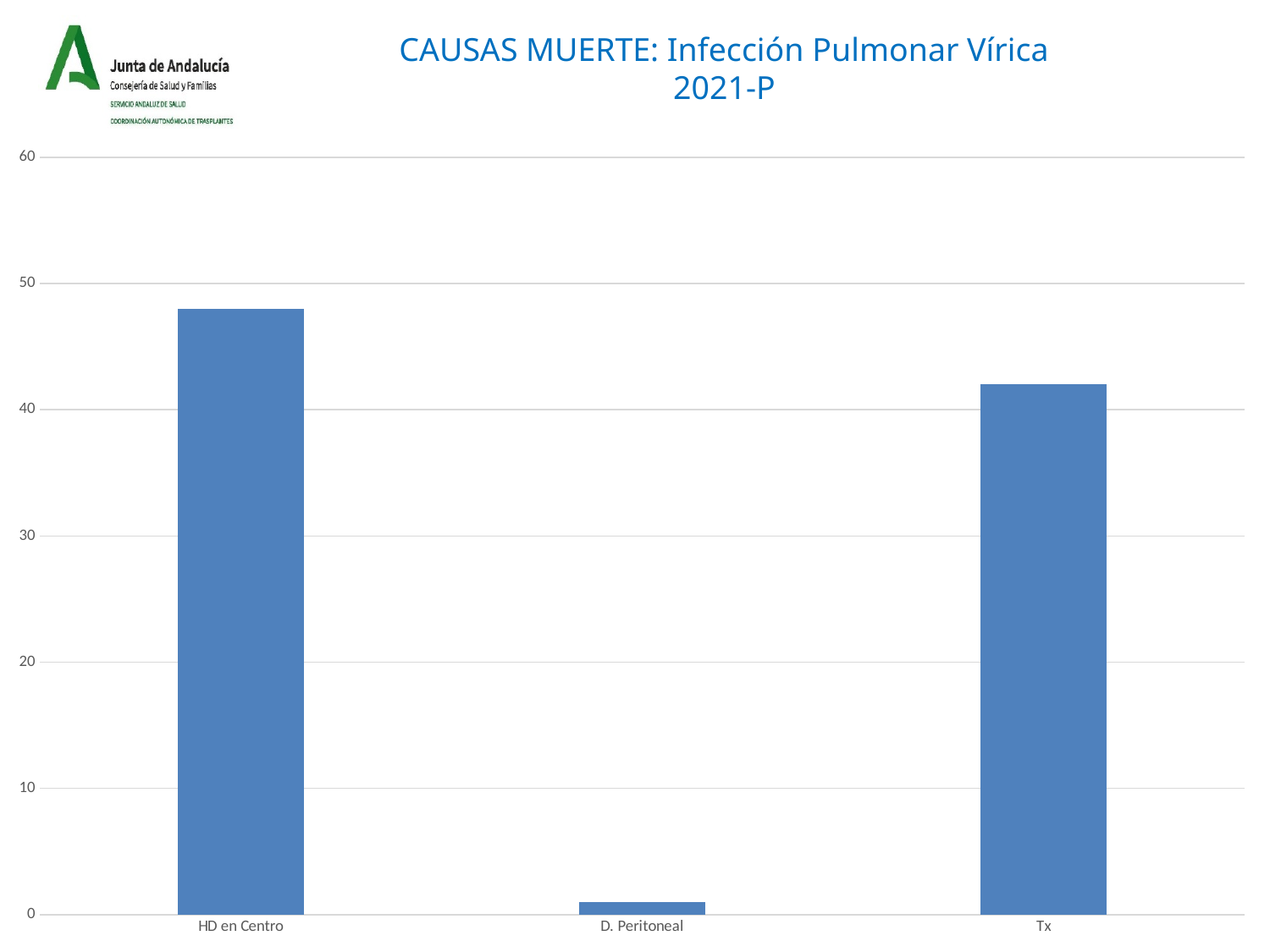
Which category has the lowest value? D. Peritoneal Is the value for HD en Centro greater or less than 50? less Which category has the highest value? HD en Centro Is the value for Tx greater or less than 40? greater Which is larger, the value for HD en Centro or the value for Tx? HD en Centro What is the highest value shown on the y axis? 60 What kind of chart is shown on the slide? bar chart Is the value for HD en Centro greater or less than 40? greater Which is larger, the value for D. Peritoneal or the value for Tx? Tx What is the title of the chart? CAUSAS MUERTE: Infección Pulmonar Vírica 2021-P How many categories are shown on the x axis? 3